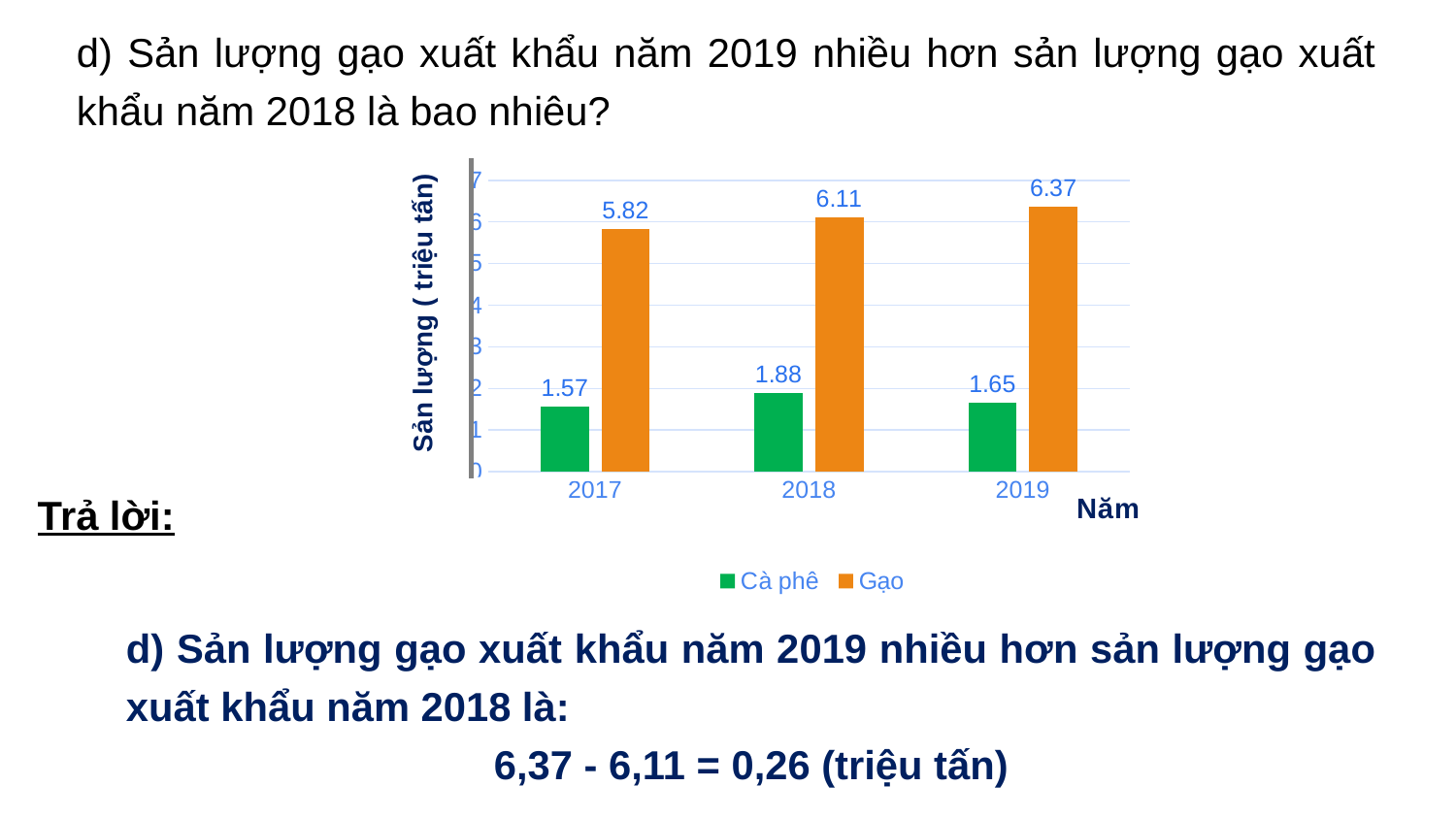
What kind of chart is shown on the slide? Bar chart What is the label of the y axis? Sản lượng ( triệu tấn) Do the Gạo values rise or fall from 2017 to 2019? Rise What is the value for Gạo in 2019? 6.37 In which year is the Cà phê value lowest? 2017 In which year is the Gạo value highest? 2019 What is the value for Gạo in 2017? 5.82 What is the value for Cà phê in 2018? 1.88 How many years are shown on the x axis? 3 How many series does the legend list? 2 Which is larger: Cà phê in 2018 or Cà phê in 2019? Cà phê in 2018 What is the difference between the Gạo values for 2019 and 2018? 0.26